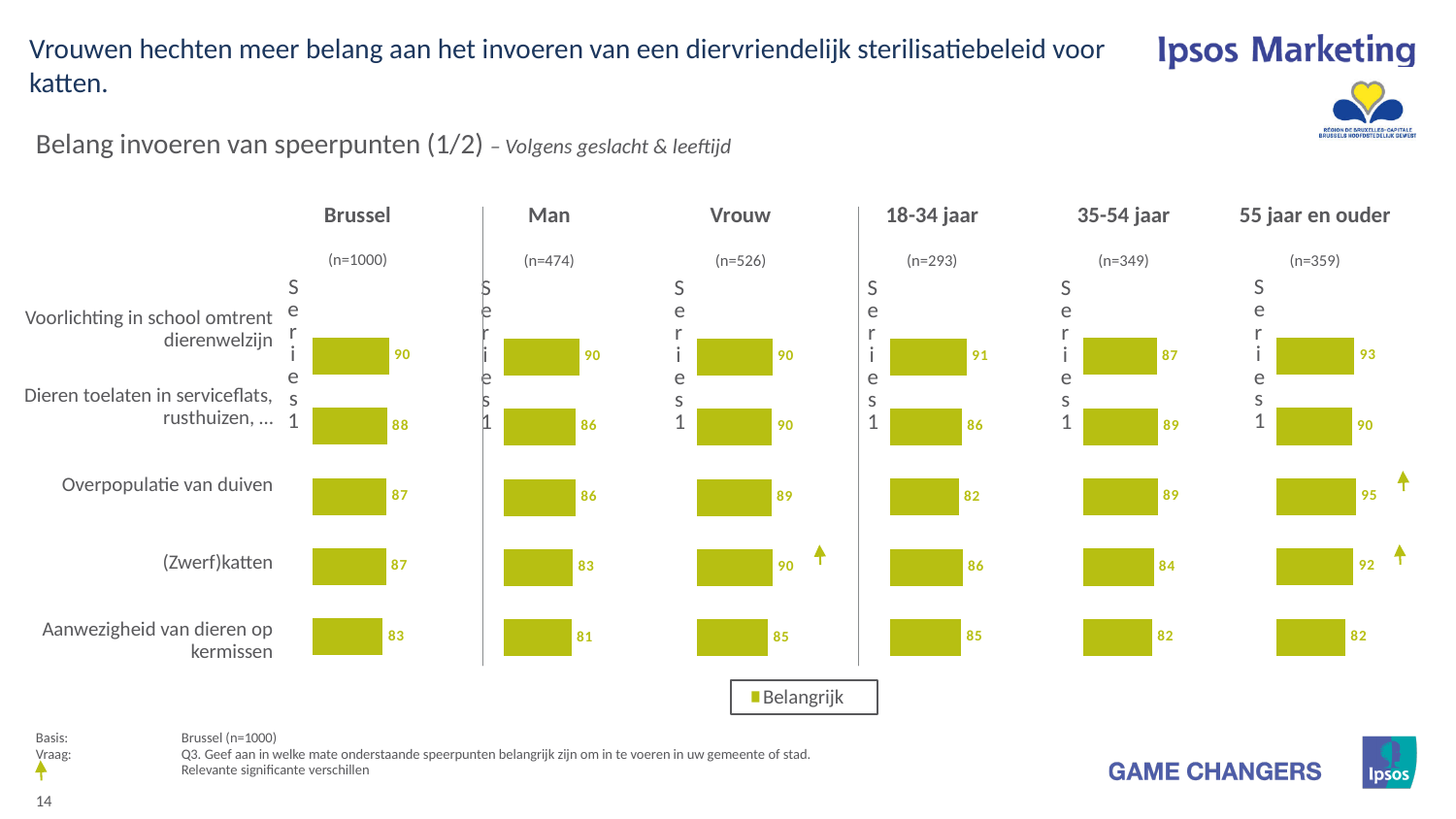
In the 18-34 jaar chart, what is the value for Aanwezigheid van dieren op kermissen? 85 In the Vrouw chart, what is the value for (Zwerf)katten? 90 What is the sample size (n) shown for the Vrouw chart? n=526 How many series does the legend list? 1 What is the difference between the (Zwerf)katten value in the Vrouw chart and in the Man chart? 7 What kind of chart is used for the Brussel data? bar chart In the Brussel chart, what is the value for Voorlichting in school omtrent dierenwelzijn? 90 In the 55 jaar en ouder chart, which category has the highest value? Overpopulatie van duiven In the Man chart, which category has the lowest value? Aanwezigheid van dieren op kermissen Which is larger: the Overpopulatie van duiven value in the 18-34 jaar chart or in the 35-54 jaar chart? 35-54 jaar What is the legend entry shown below the charts? Belangrijk How many categories are shown in the Brussel chart? 5